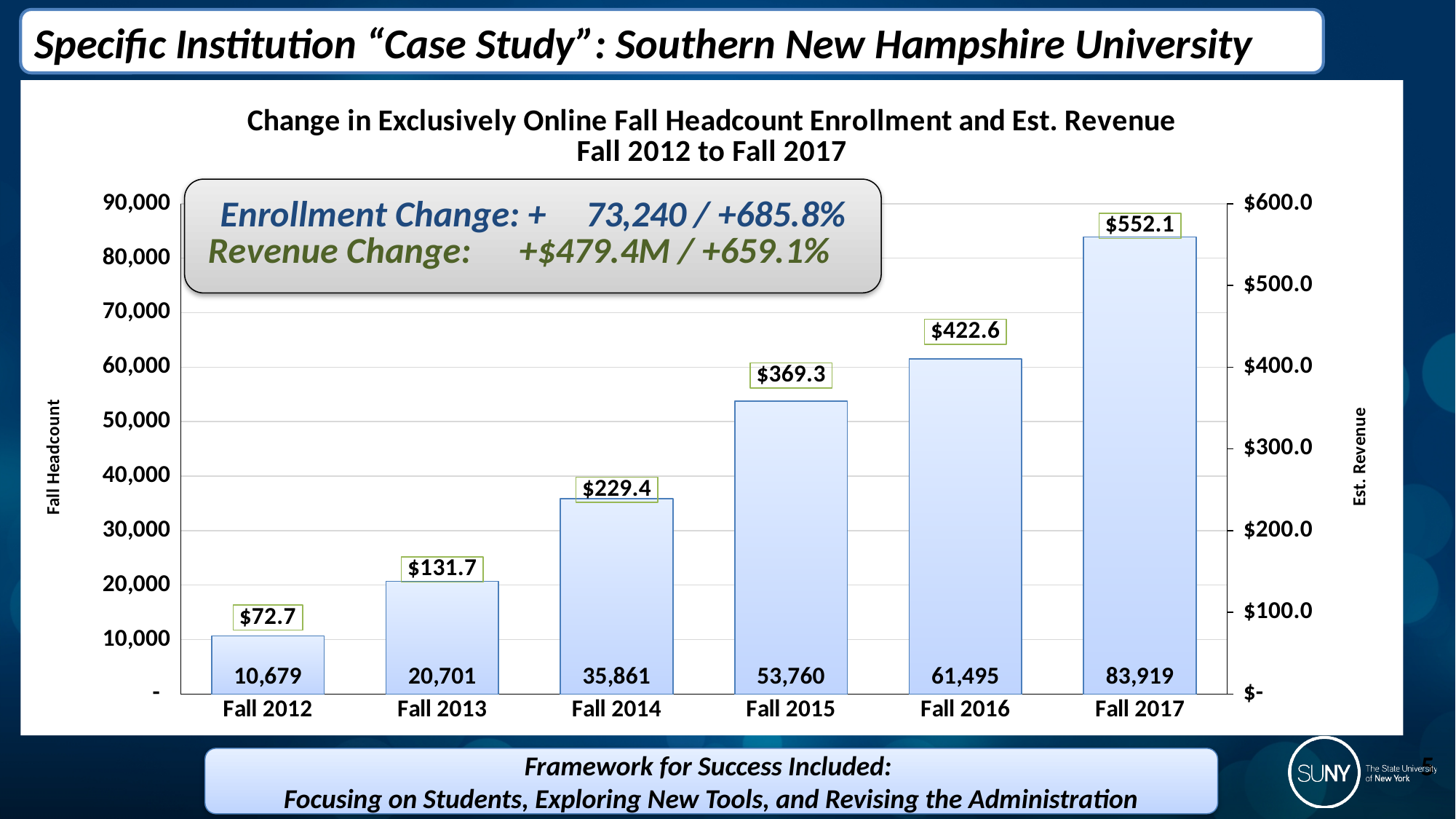
What is the difference in Est. Revenue between Fall 2017 and Fall 2016? $129.5 What is the difference in Fall Headcount between Fall 2016 and Fall 2015? 7,735 Which has a larger Fall Headcount, Fall 2013 or Fall 2014? Fall 2014 What is the Fall Headcount for Fall 2015? 53,760 Which fall term has the highest Fall Headcount? Fall 2017 What is the Fall Headcount for Fall 2012? 10,679 What is the Est. Revenue label shown for Fall 2014? $229.4 Which fall term has the lowest Est. Revenue? Fall 2012 Is the Fall Headcount for Fall 2016 greater or less than 60,000? greater How many fall terms are shown on the x axis? 6 What kind of chart is shown on the slide? Bar chart Do the Fall Headcount values rise or fall from Fall 2012 to Fall 2017? Rise